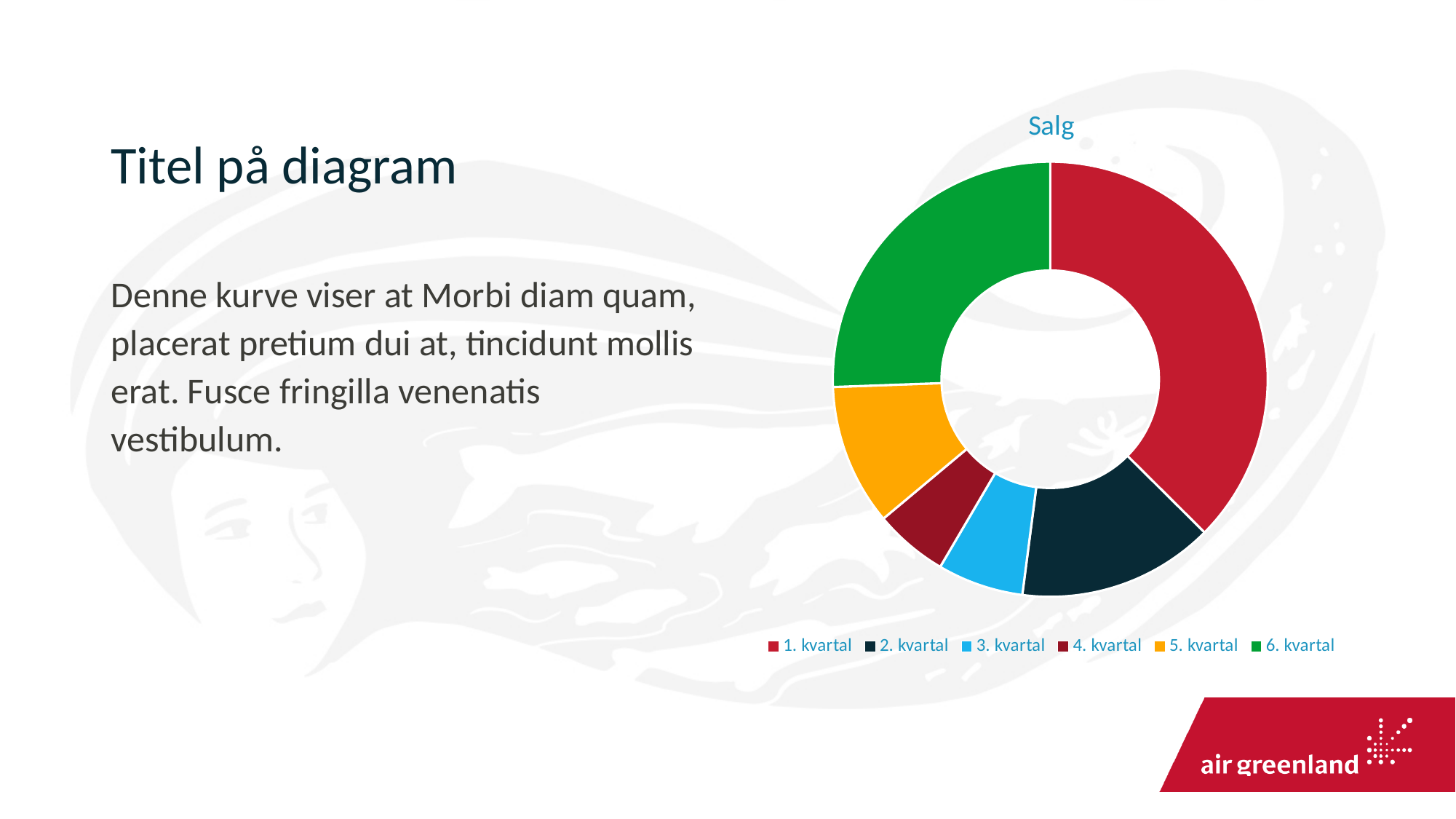
Which slice is larger, 6. kvartal or 5. kvartal? 6. kvartal Is the share of 1. kvartal greater or less than half of the chart? less How many categories does the chart show? 6 Which slice is larger, 1. kvartal or 6. kvartal? 1. kvartal Which category is shown in green in the chart? 6. kvartal Which slice is larger, 2. kvartal or 3. kvartal? 2. kvartal Which category has the largest slice in the chart? 1. kvartal What kind of chart is shown on the slide? Doughnut (pie) chart How many entries does the chart legend list? 6 What is the title of the chart? Salg